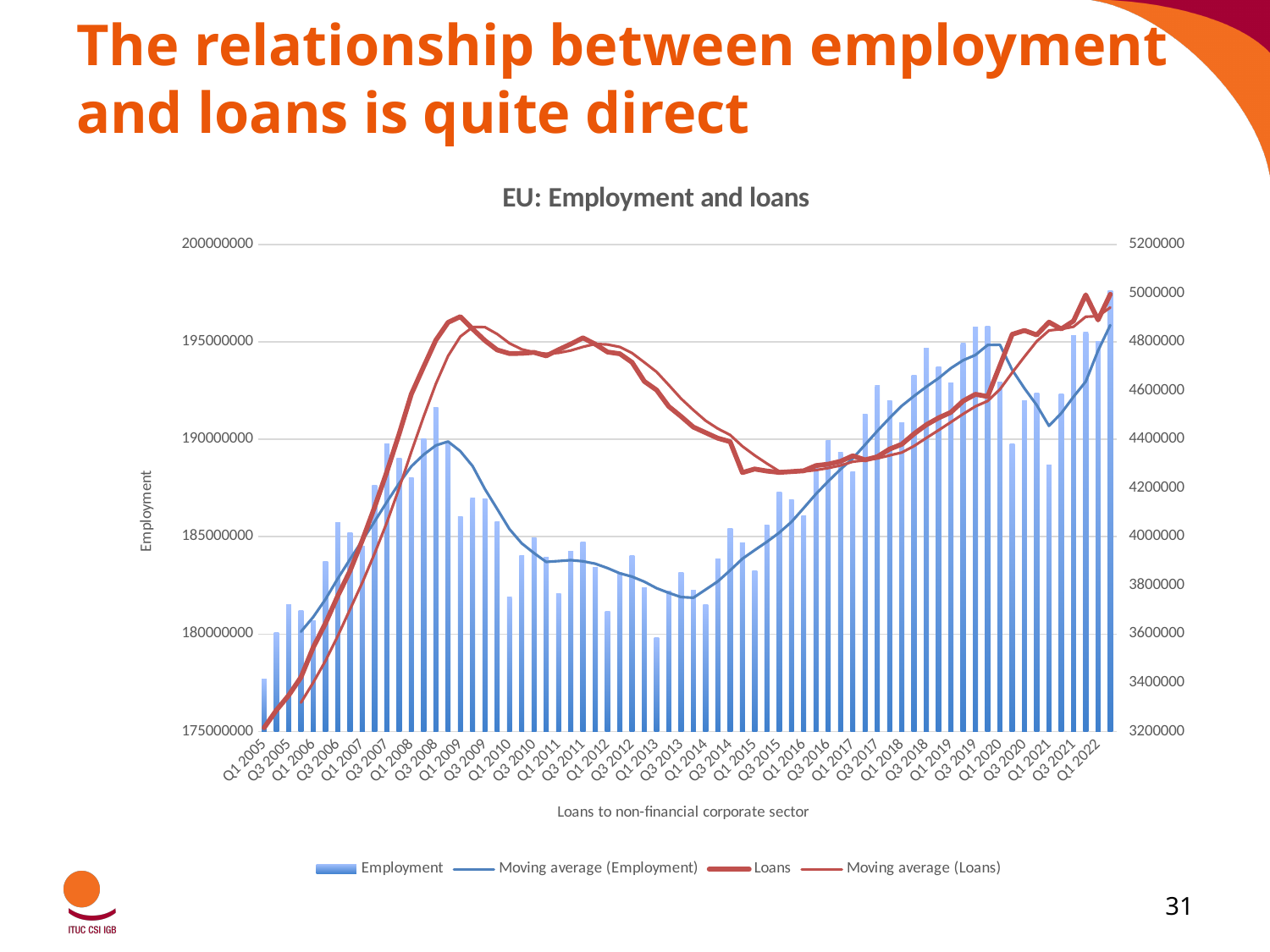
Is the Loans value for Q1 2022 greater or less than 4800000? greater Is the Employment value for Q1 2009 greater or less than 190000000? less Does the Loans line rise or fall from Q1 2009 to Q1 2015? fall What is the title of the chart on the slide? EU: Employment and loans Which series in the chart is drawn as bars? Employment Is the Employment value for Q1 2005 greater or less than 180000000? less What kind of chart is shown on the slide? Combined bar and line chart Do the Employment bars rise or fall from Q1 2005 to Q1 2009? rise Which quarter has the lowest Employment bar? Q1 2005 How many series does the chart's legend list? 4